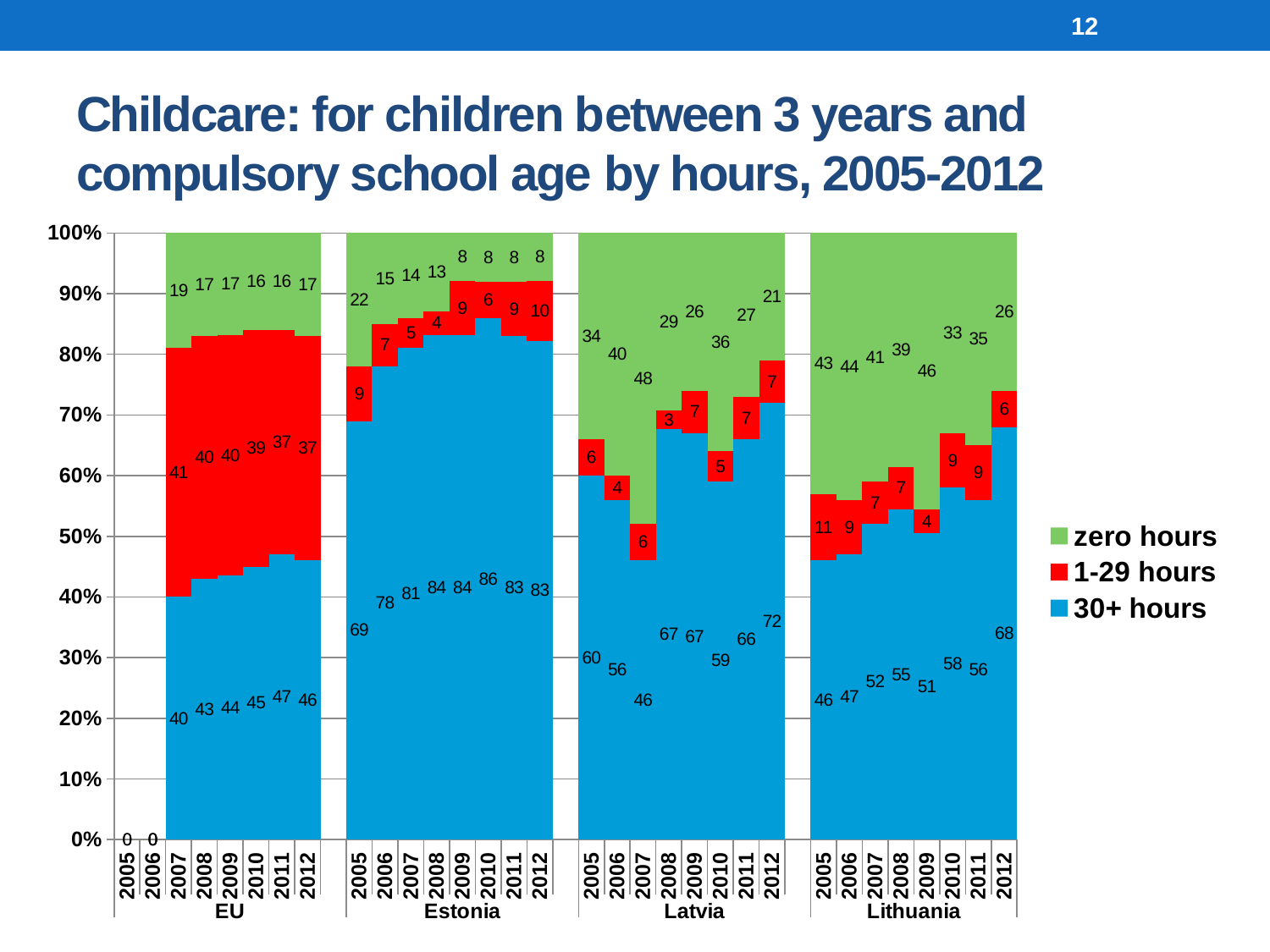
What kind of chart is shown on the slide? stacked bar chart How many series does the legend list? 3 What is the value for 30+ hours in Estonia in 2010? 86 Which year has the lowest 30+ hours value for Latvia? 2007 What is the value for zero hours in Latvia in 2007? 48 Does the 30+ hours value for Estonia rise or fall from 2005 to 2008? rise Which year has the highest 30+ hours value for Lithuania? 2012 What is the total of the stacked bar for Lithuania in 2012? 100 What is the difference between the 30+ hours values for Estonia and Latvia in 2012? 11 What is the value for 1-29 hours in the EU in 2007? 41 Which colour represents the 1-29 hours series? red Which is larger in 2005: the zero hours value for Estonia or for Lithuania? Lithuania